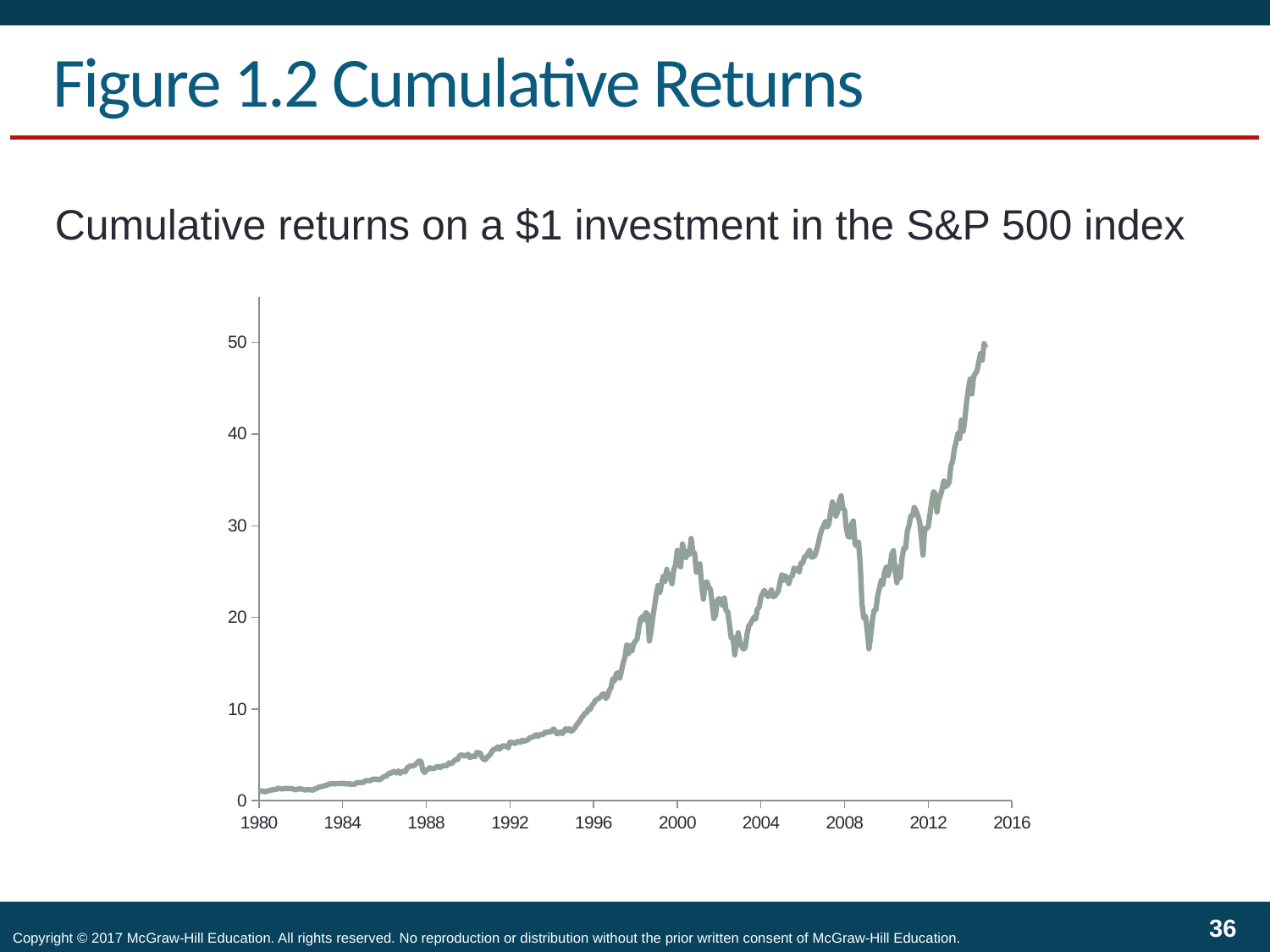
Is the value of the cumulative return around 1984 greater or less than 10? less Is the cumulative return around 2012 larger or smaller than the cumulative return around 1992? larger How many lines (series) are plotted on the chart? 1 What is the highest tick label shown on the vertical axis? 50 What kind of chart is shown on the slide? line chart Is the value of the cumulative return around 1992 greater or less than 10? less Is the highest value reached by the line greater or less than 40? greater Overall, do the cumulative returns rise or fall from 1980 to the end of the series? rise What is the first year labelled on the horizontal axis? 1980